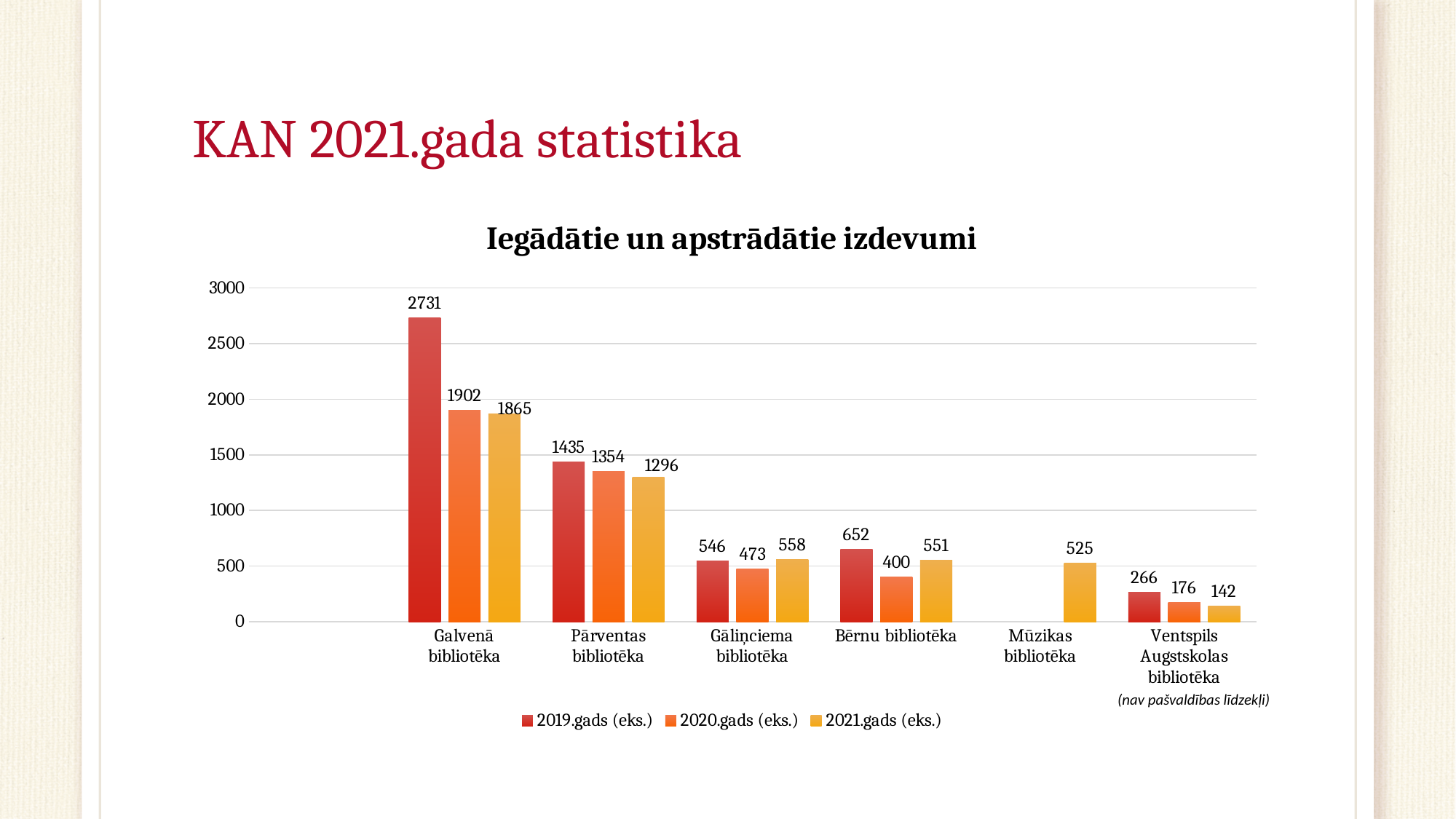
What is the value for Mūzikas bibliotēka in the 2021.gads (eks.) series? 525 What is the difference between the 2019.gads (eks.) and 2021.gads (eks.) values for Galvenā bibliotēka? 866 How many categories are shown on the x axis? 6 What is the value for Pārventas bibliotēka in the 2021.gads (eks.) series? 1296 What is the value for Galvenā bibliotēka in the 2019.gads (eks.) series? 2731 What is the value for Bērnu bibliotēka in the 2020.gads (eks.) series? 400 How many series does the legend list? 3 Which category has the lowest value in the 2019.gads (eks.) series? Ventspils Augstskolas bibliotēka What is the title of the chart? Iegādātie un apstrādātie izdevumi Which is larger for Gāliņciema bibliotēka: the 2019.gads (eks.) value or the 2021.gads (eks.) value? 2021.gads (eks.) Which category has the highest value in the 2021.gads (eks.) series? Galvenā bibliotēka What kind of chart is shown on the slide? Bar chart